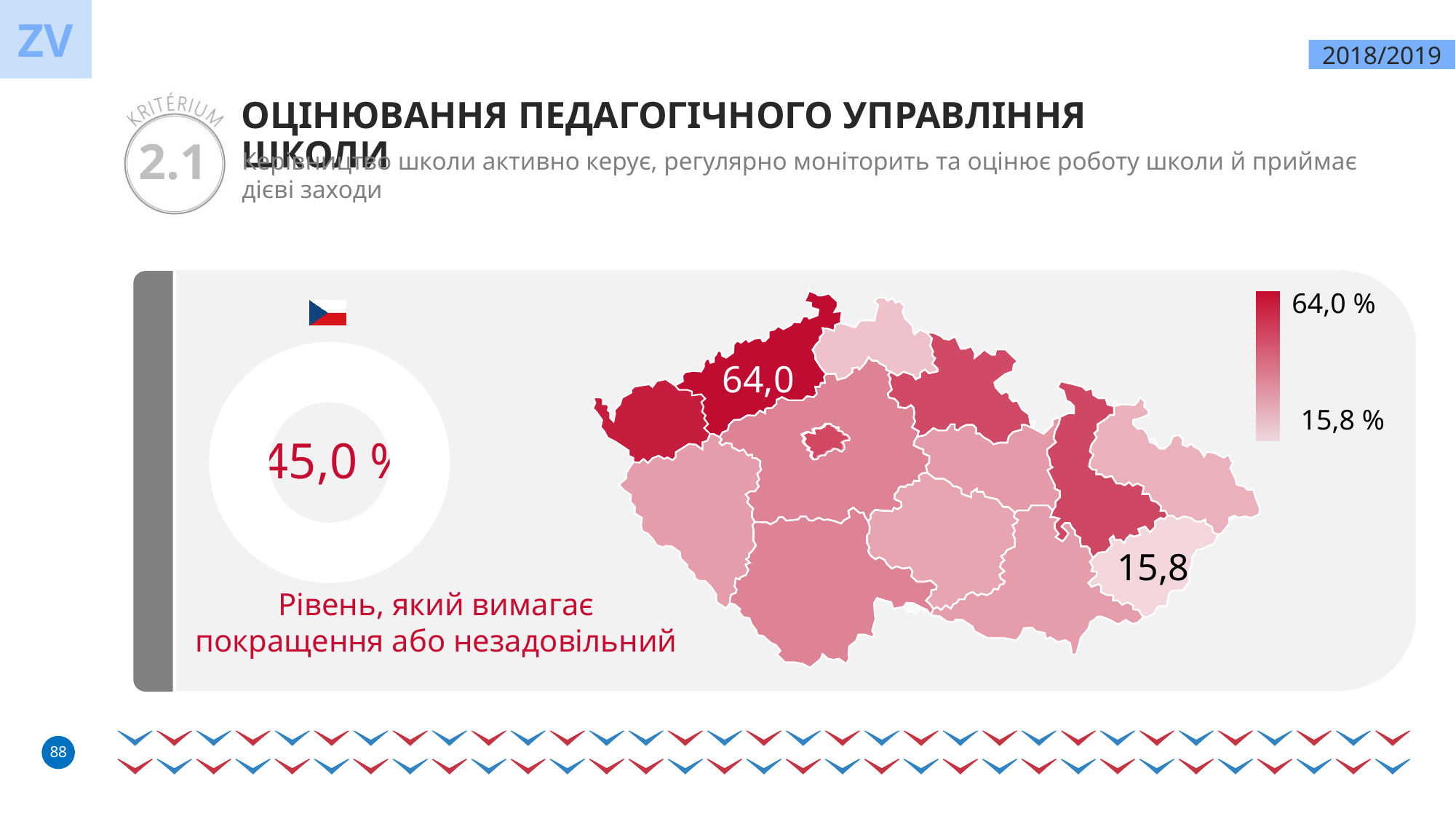
What kind of chart is shown on the left side of the grey panel? Donut chart Is the value shown in the donut chart greater or less than 50 %? less Which region on the map is shaded lightest? The region labelled 15,8 (south-east) Which region on the map is shaded darkest red? The region labelled 64,0 (north-west) What value is shown in the centre of the donut chart on the left? 45,0 % What is the highest value labelled on the map of the Czech Republic? 64,0 What kind of chart is shown on the right side of the grey panel? Map (choropleth) What is the lower value of the colour scale legend next to the map? 15,8 % On the map, which labelled region value is larger: 64,0 or 15,8? 64,0 What is the upper value of the colour scale legend next to the map? 64,0 % What is the lowest value labelled on the map of the Czech Republic? 15,8 On the map, what is the difference between the highest labelled value (64,0) and the lowest labelled value (15,8)? 48,2